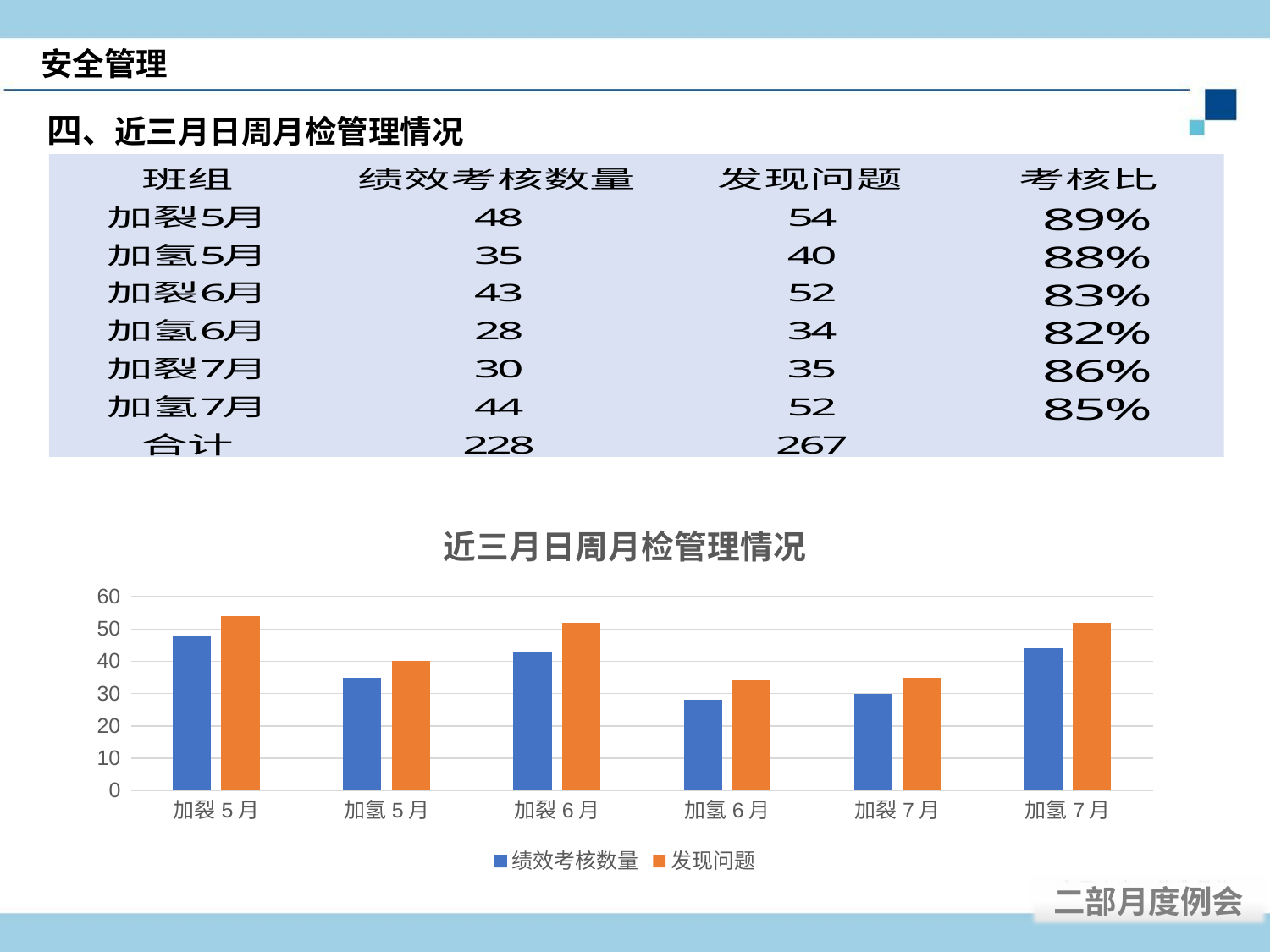
What type of chart is shown on the slide? Bar chart Which category has the lowest 绩效考核数量 value? 加氢6月 Which category has the highest 发现问题 value? 加裂5月 What is the difference between 发现问题 and 绩效考核数量 for 加裂6月? 9 How many series does the chart legend list? 2 What is the title of the chart? 近三月日周月检管理情况 What is the value of 绩效考核数量 for 加裂5月? 48 What is the value of 发现问题 for 加氢6月? 34 Is the 绩效考核数量 value for 加裂7月 greater or less than 40? less Which is larger for 加氢7月: 绩效考核数量 or 发现问题? 发现问题 Which series is shown in orange in the chart? 发现问题 How many categories are shown on the x axis of the chart? 6